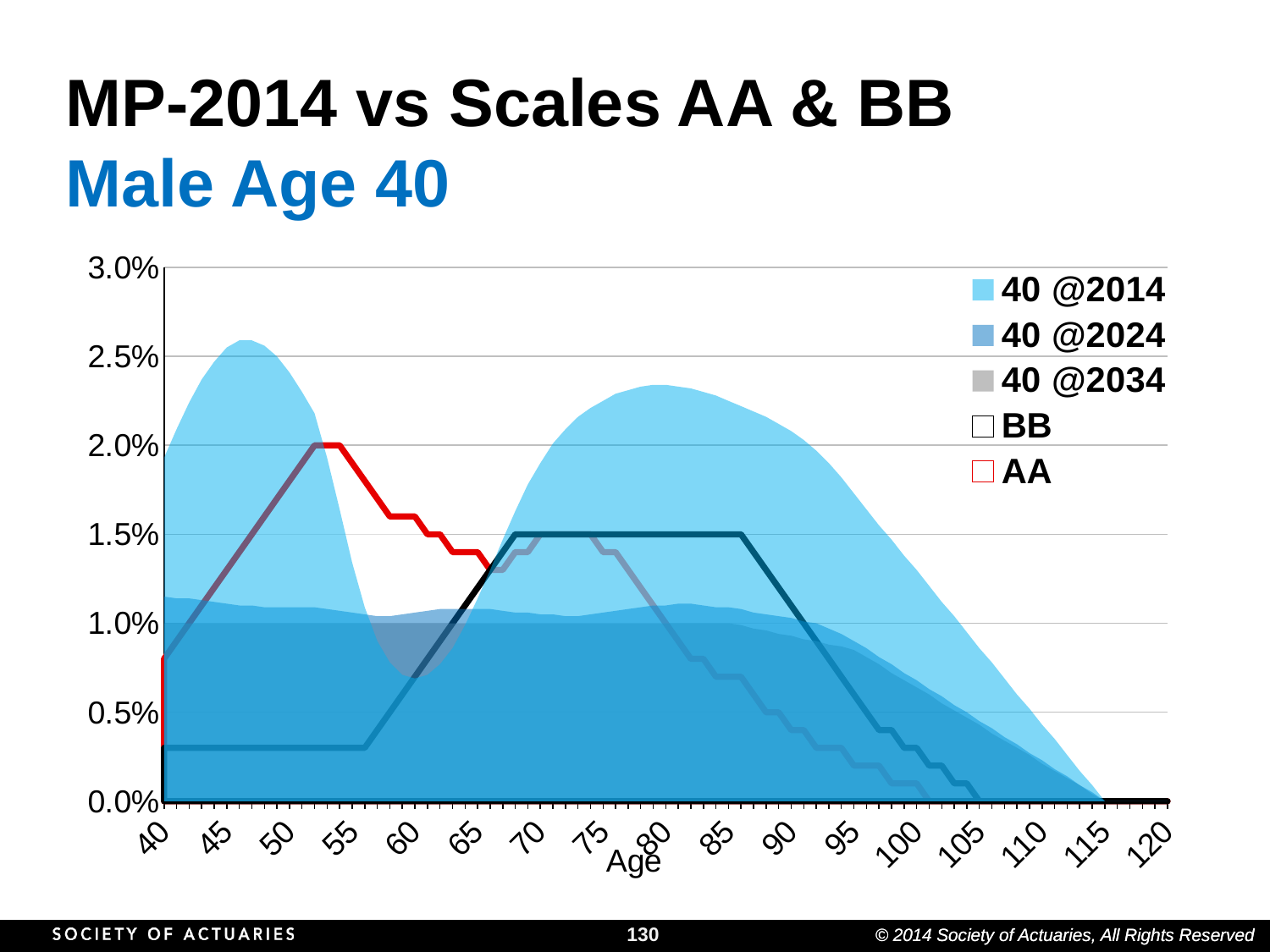
Which series reaches the highest value anywhere on the chart? 40 @2014 How many series does the legend list? 5 At age 80, which is larger: the 40 @2014 series or the BB series? 40 @2014 Is the value of the 40 @2014 series at age 80 greater or less than 2.0%? greater What is the label of the x axis? Age Is the value of the BB series at age 50 greater or less than 0.5%? less What is the title of the chart on the slide? MP-2014 vs Scales AA & BB Male Age 40 What kind of chart is shown on the slide? area chart Is the value of the AA series at age 60 greater or less than 1.5%? greater Does the 40 @2014 series rise or fall between age 80 and age 115? fall How many age labels are shown along the x axis? 17